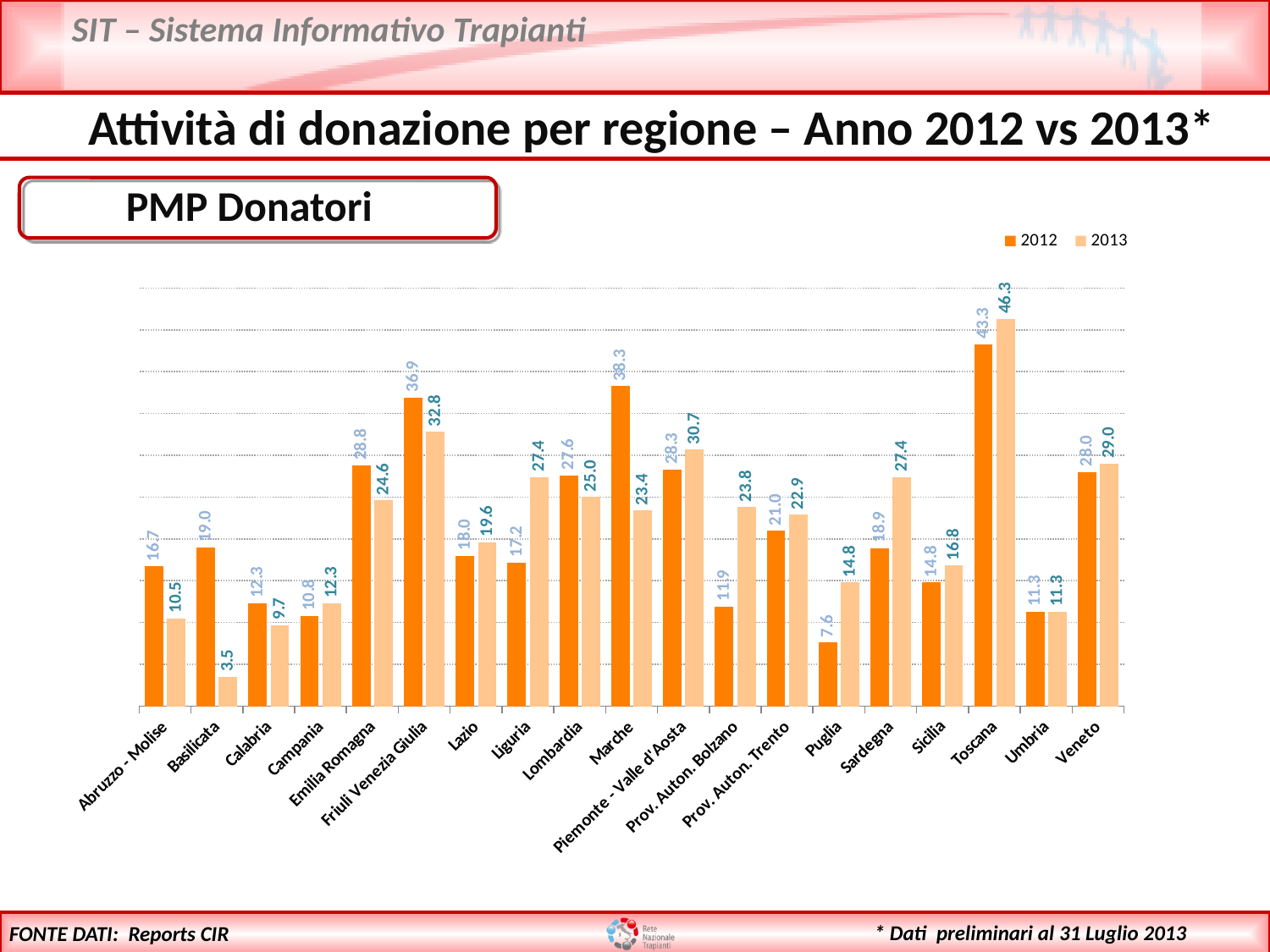
What is the 2012 value for Marche? 38.3 What kind of chart is shown? Bar chart How many regions are shown on the x axis? 19 Which region has the highest 2012 value? Toscana What is the 2013 value for Basilicata? 3.5 Which region has the lowest 2013 value? Basilicata What is the 2013 value for Toscana? 46.3 What are the two series named in the legend? 2012 and 2013 How many series does the legend list? 2 What is the difference between the 2013 and 2012 values for Liguria? 10.2 Which region has the lowest 2012 value? Puglia Which is larger for Marche, the 2012 value or the 2013 value? 2012